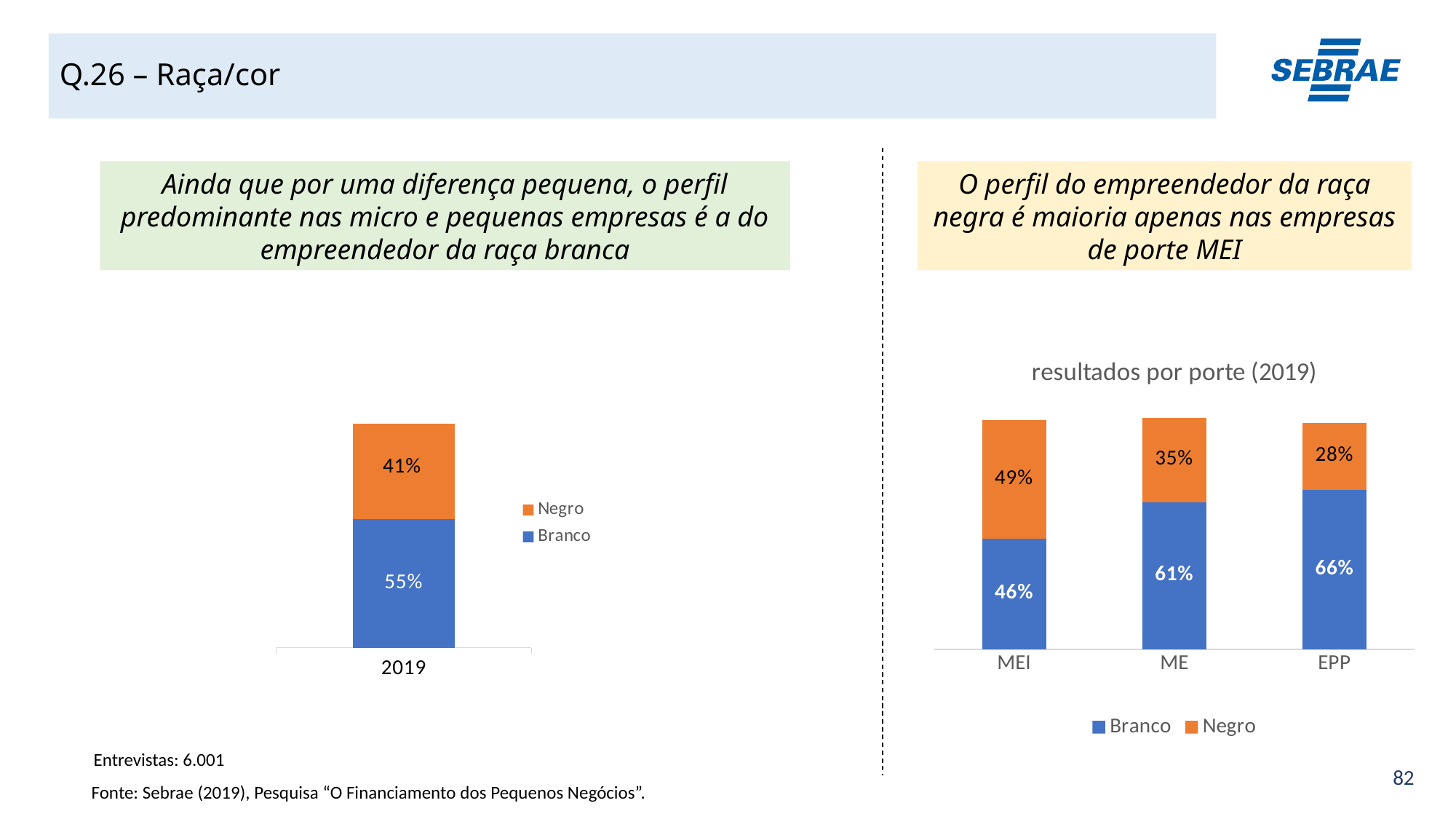
In the chart titled 'resultados por porte (2019)', what is the Negro value for EPP? 28% In the chart titled 'resultados por porte (2019)', what is the Branco value for MEI? 46% In the chart titled 'resultados por porte (2019)', does the Negro value rise or fall from MEI to EPP? fall In the left chart (2019), what is the value for Branco? 55% In the left chart (2019), what is the difference between the Branco and Negro values? 14% In the chart titled 'resultados por porte (2019)', which category has the highest Branco value? EPP What kind of chart is the chart titled 'resultados por porte (2019)'? stacked bar chart In the left chart (2019), what is the value for Negro? 41% In the chart titled 'resultados por porte (2019)', which category has the lowest Negro value? EPP In the chart titled 'resultados por porte (2019)', how many categories are shown on the x axis? 3 In the left chart (2019), which is larger, Branco or Negro? Branco In the chart titled 'resultados por porte (2019)', what is the difference between the Branco values for ME and MEI? 15%